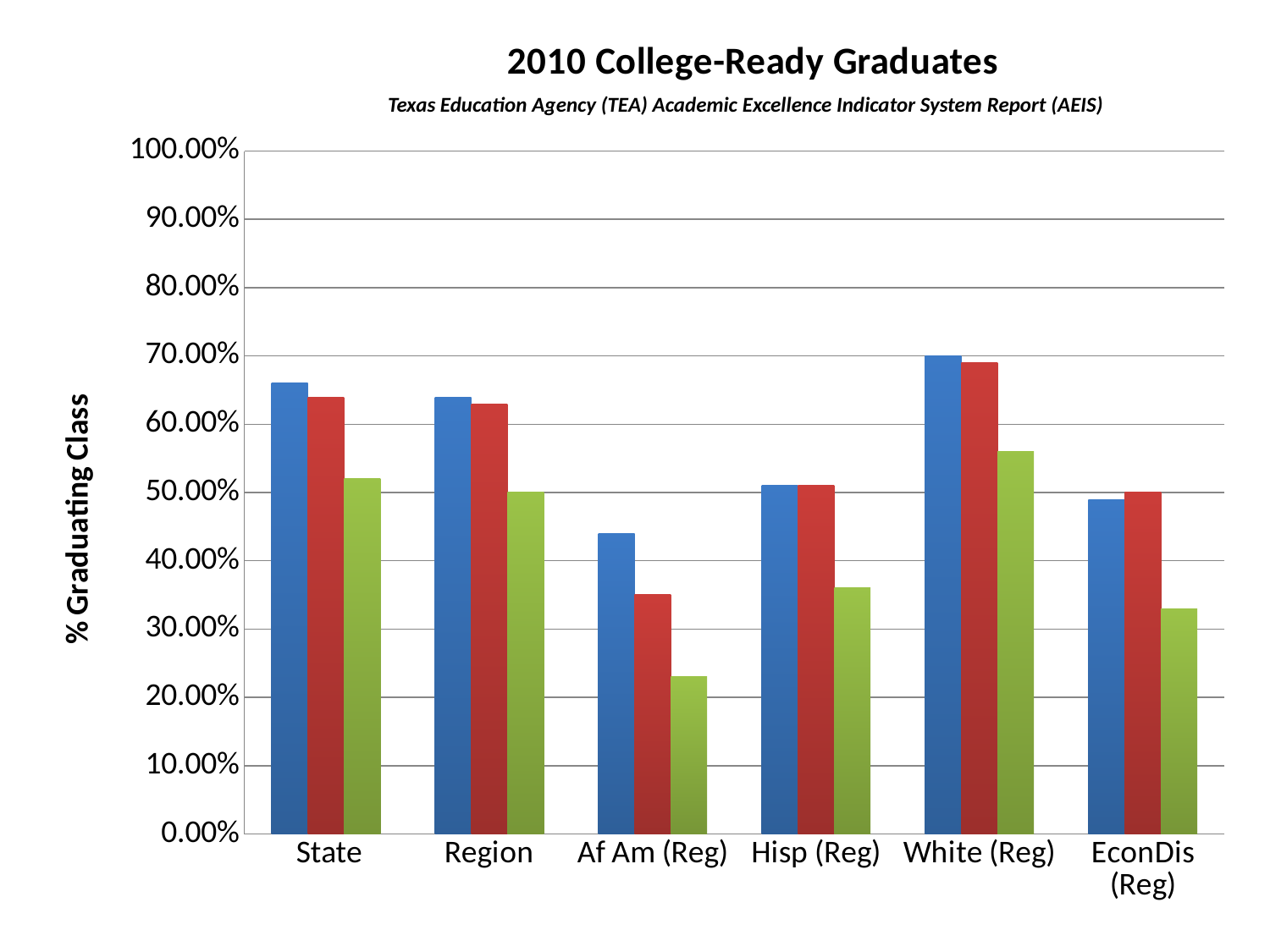
Which category has the shortest green bar? Af Am (Reg) Is the green bar for Hisp (Reg) greater or less than 40.00%? less Which category has the shortest red bar? Af Am (Reg) Is the green bar for Af Am (Reg) greater or less than 30.00%? less Is the blue bar for State greater or less than 60.00%? greater Which category has the tallest blue bar? White (Reg) Which green bar is taller: White (Reg) or State? White (Reg) What kind of chart is shown on the slide? bar chart How many categories are shown on the x axis? 6 What is the label on the vertical axis? % Graduating Class For Af Am (Reg), which is larger: the blue bar or the red bar? the blue bar What is the title of the chart? 2010 College-Ready Graduates